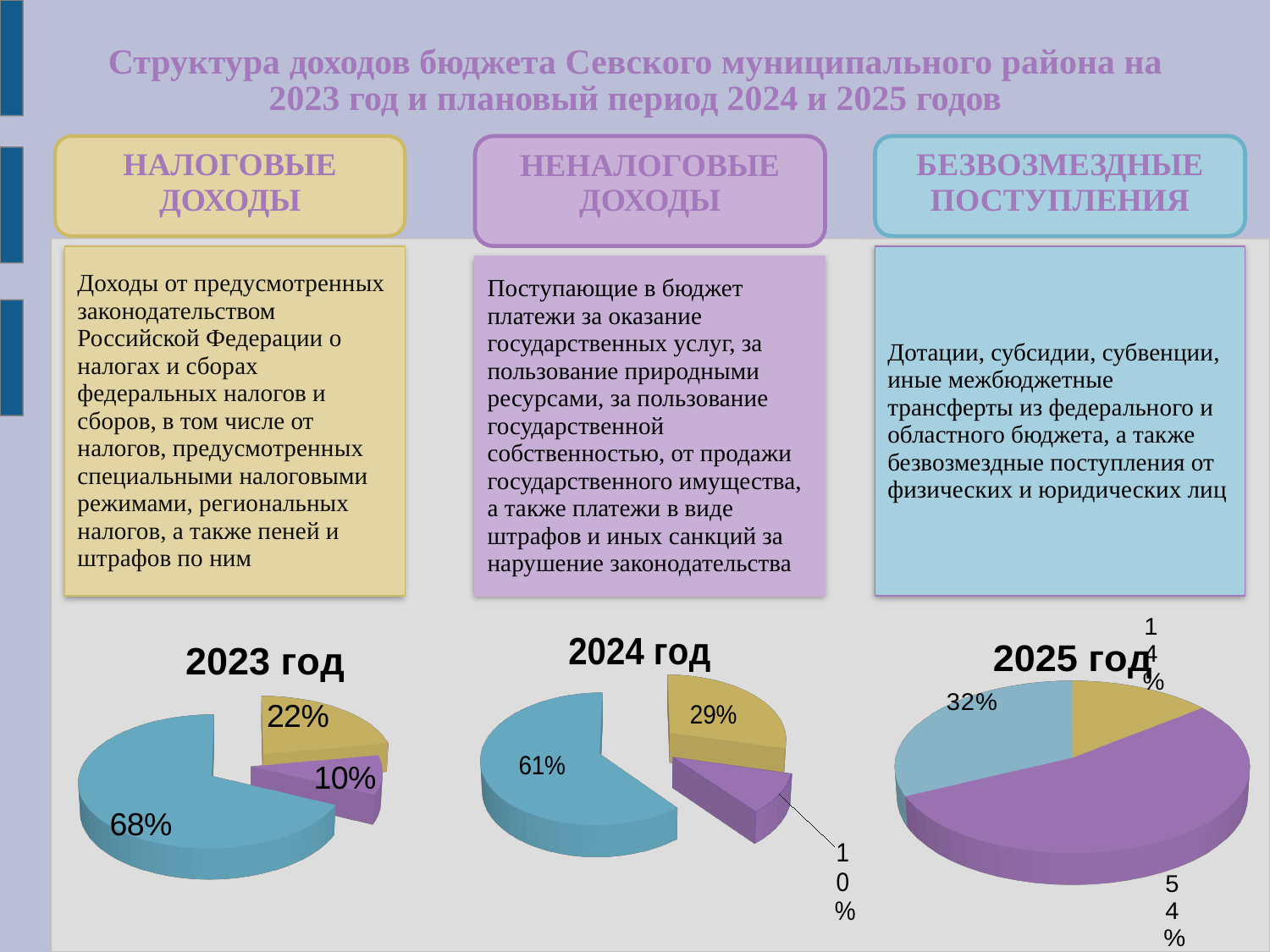
In the 2023 год chart, what is the value of the smallest slice? 10% In the 2025 год chart, what is the value of the purple slice? 54% In the 2025 год chart, which slice is the smallest? the yellow slice (14%) What is the difference between the blue slice in the 2023 год chart and the blue slice in the 2025 год chart? 36% How many pie charts are shown on the slide? 3 In the 2023 год chart, what is the value of the largest slice? 68% What kind of chart is used for the 2023 год chart? pie chart How many slices does the 2024 год chart have? 3 In the 2023 год chart, what is the value of the yellow slice? 22% In the 2025 год chart, which is larger, the blue slice or the purple slice? the purple slice In the 2024 год chart, what is the value of the blue slice? 61% In the 2024 год chart, what is the difference between the yellow slice and the purple slice? 19%